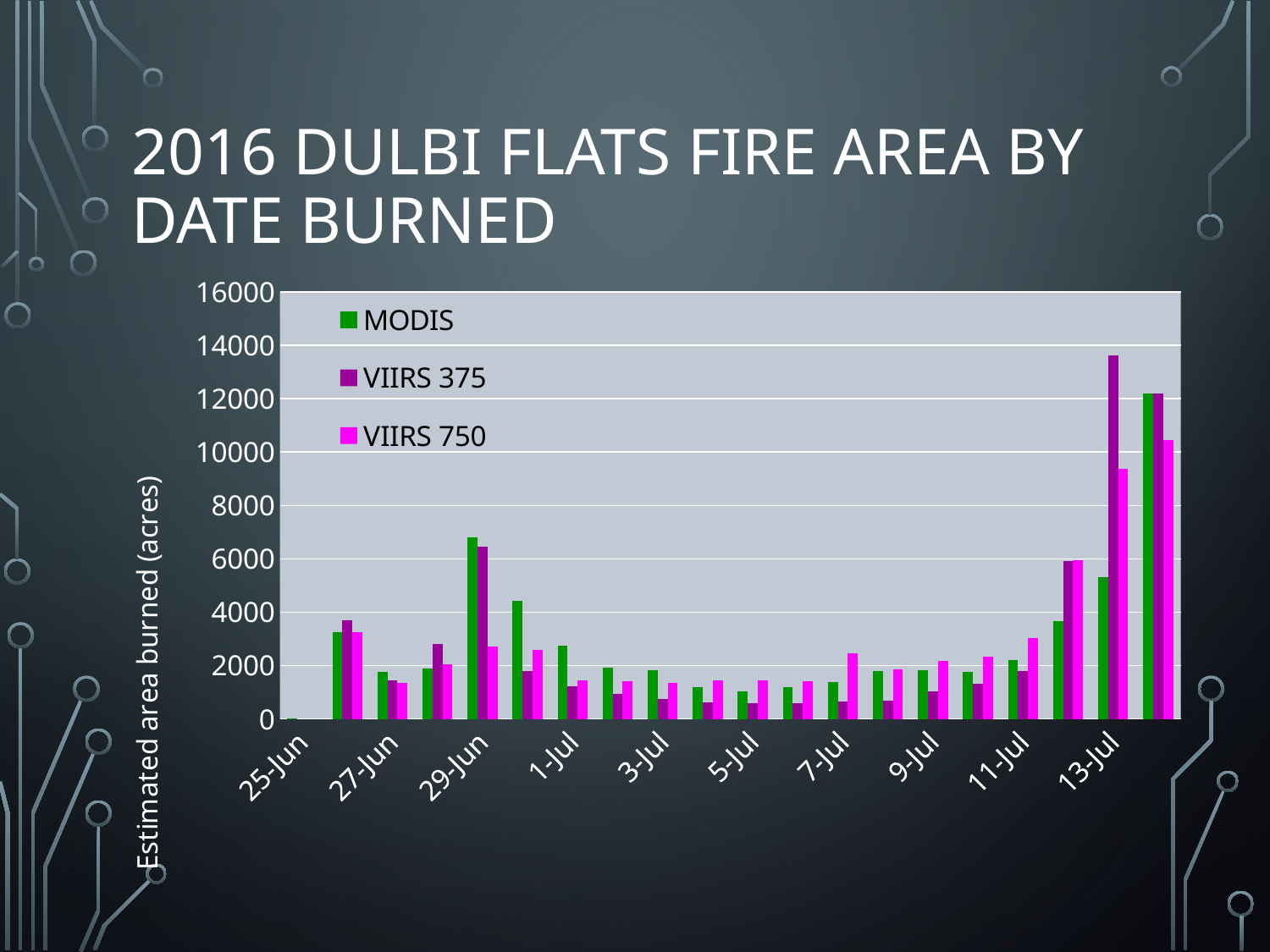
Is the VIIRS 750 value on 13-Jul greater or less than 8000? greater Is the VIIRS 375 value on 5-Jul greater or less than 2000? less What is the title of the chart's vertical axis? Estimated area burned (acres) Is the MODIS value on 29-Jun greater or less than 6000? greater On 29-Jun, which is larger: the MODIS value or the VIIRS 750 value? MODIS Which series has the tallest bar on 13-Jul? VIIRS 375 Which colour represents the MODIS series in the legend? green How many series does the legend list? 3 What kind of chart is shown on the slide? bar chart On 7-Jul, which is larger: the VIIRS 750 value or the VIIRS 375 value? VIIRS 750